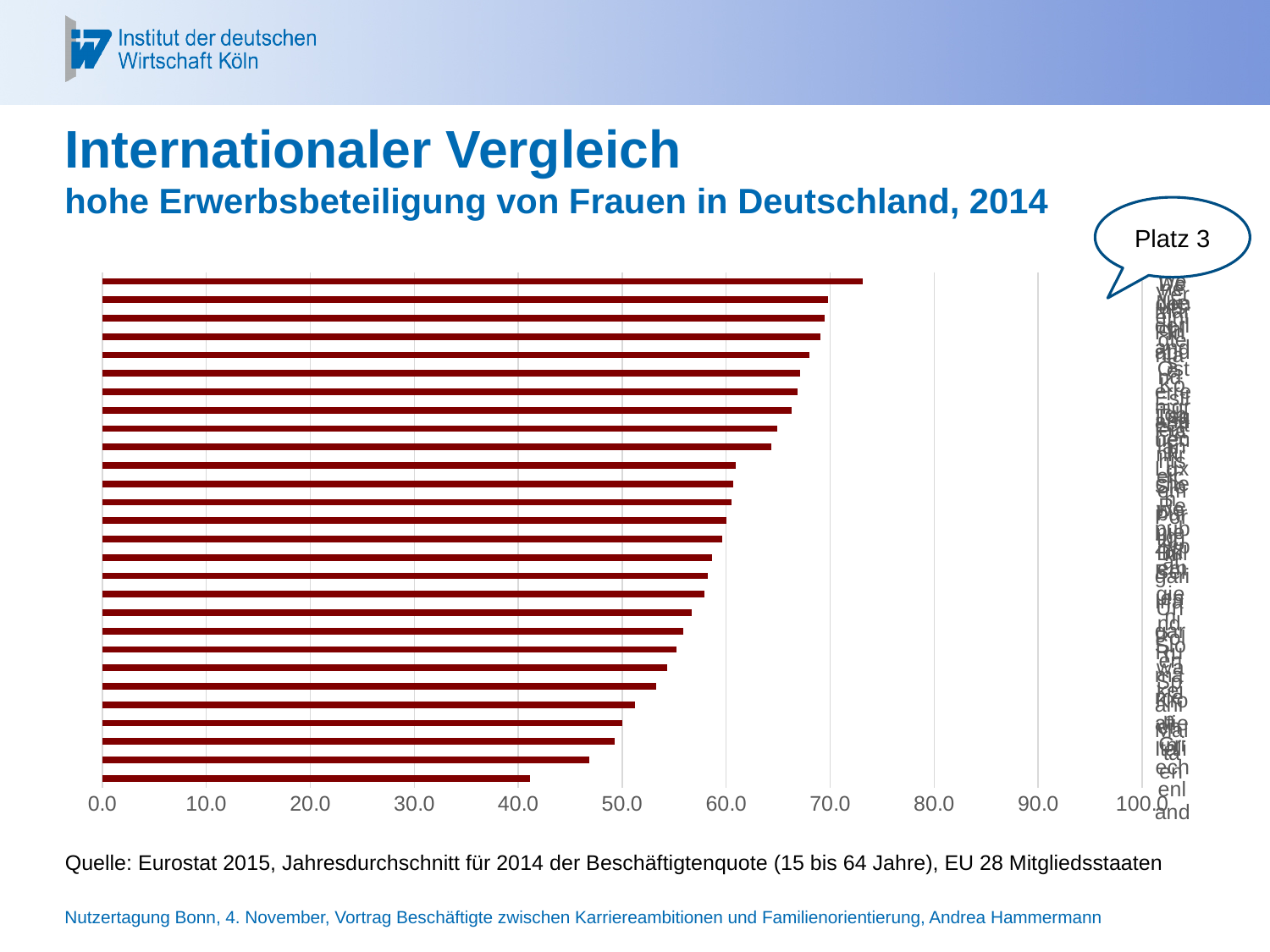
Going from the top bar to the bottom bar, do the values increase or decrease? decrease What does the callout bubble next to the chart say? Platz 3 Is the value of the shortest (bottom) bar greater or less than 40.0? greater What is the highest tick value shown on the x axis? 100.0 Which bar has the lowest value, the top one or the bottom one? the bottom one What kind of chart is shown on the slide? bar chart Do any bars in the chart reach beyond 80.0 on the x axis? No Which bar has the highest value, the top one or the bottom one? the top one Is the value of the longest (top) bar greater or less than 70.0? greater